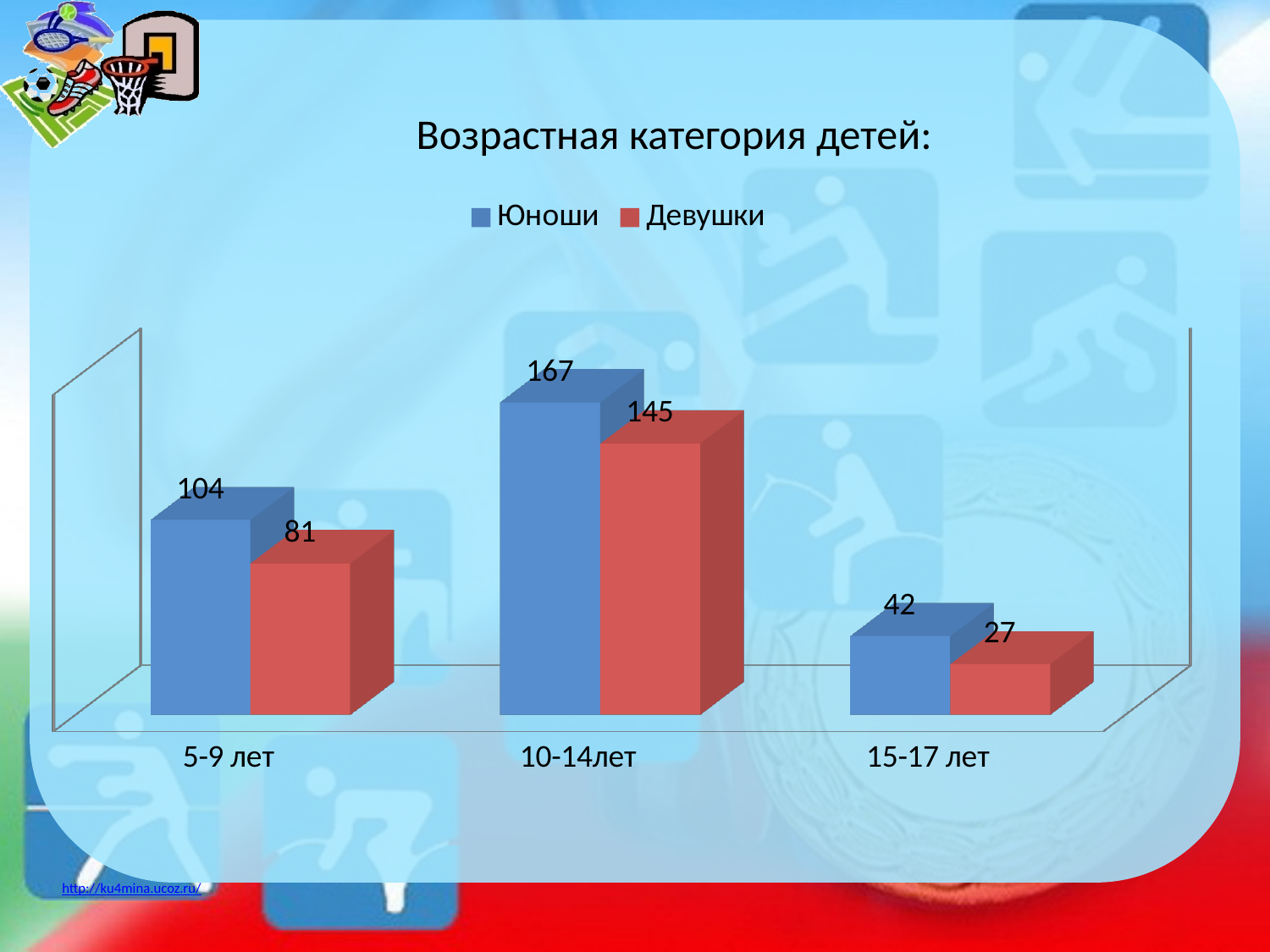
What kind of chart is shown on the slide? bar chart What is the difference between Юноши and Девушки in the 5-9 лет category? 23 Which age category has the highest value for Юноши? 10-14лет Which age category has the lowest value for Девушки? 15-17 лет Which is larger in the 15-17 лет category, Юноши or Девушки? Юноши What is the difference between Юноши and Девушки in the 10-14лет category? 22 What is the value for Девушки in the 15-17 лет category? 27 What is the value for Девушки in the 10-14лет category? 145 How many age categories are shown on the x axis? 3 How many series does the legend list? 2 What is the title of the chart? Возрастная категория детей: What is the value for Юноши in the 5-9 лет category? 104